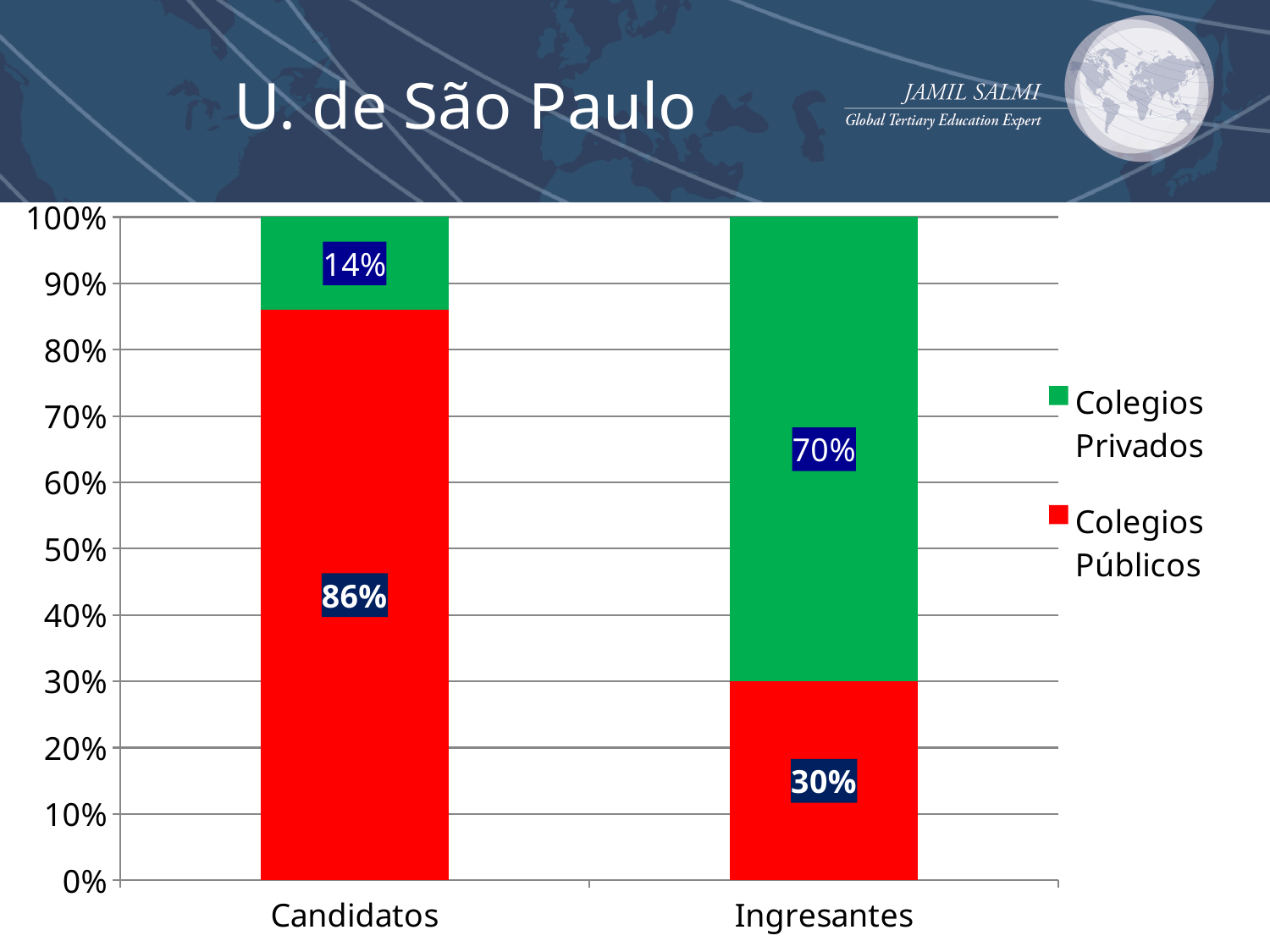
What is the value for Colegios Privados in the Ingresantes bar? 70% What is the difference between the Colegios Públicos values for Candidatos and Ingresantes? 56% What is the difference between the Colegios Privados values for Ingresantes and Candidatos? 56% How many series does the legend list? 2 What kind of chart is shown on the slide? Stacked bar chart What is the value for Colegios Privados in the Candidatos bar? 14% How many categories are shown on the x axis? 2 What is the total of the stacked bar for Ingresantes? 100% What is the value for Colegios Públicos in the Candidatos bar? 86% Which colour represents Colegios Privados in the chart? Green Which category has the higher value for Colegios Públicos, Candidatos or Ingresantes? Candidatos What is the value for Colegios Públicos in the Ingresantes bar? 30%